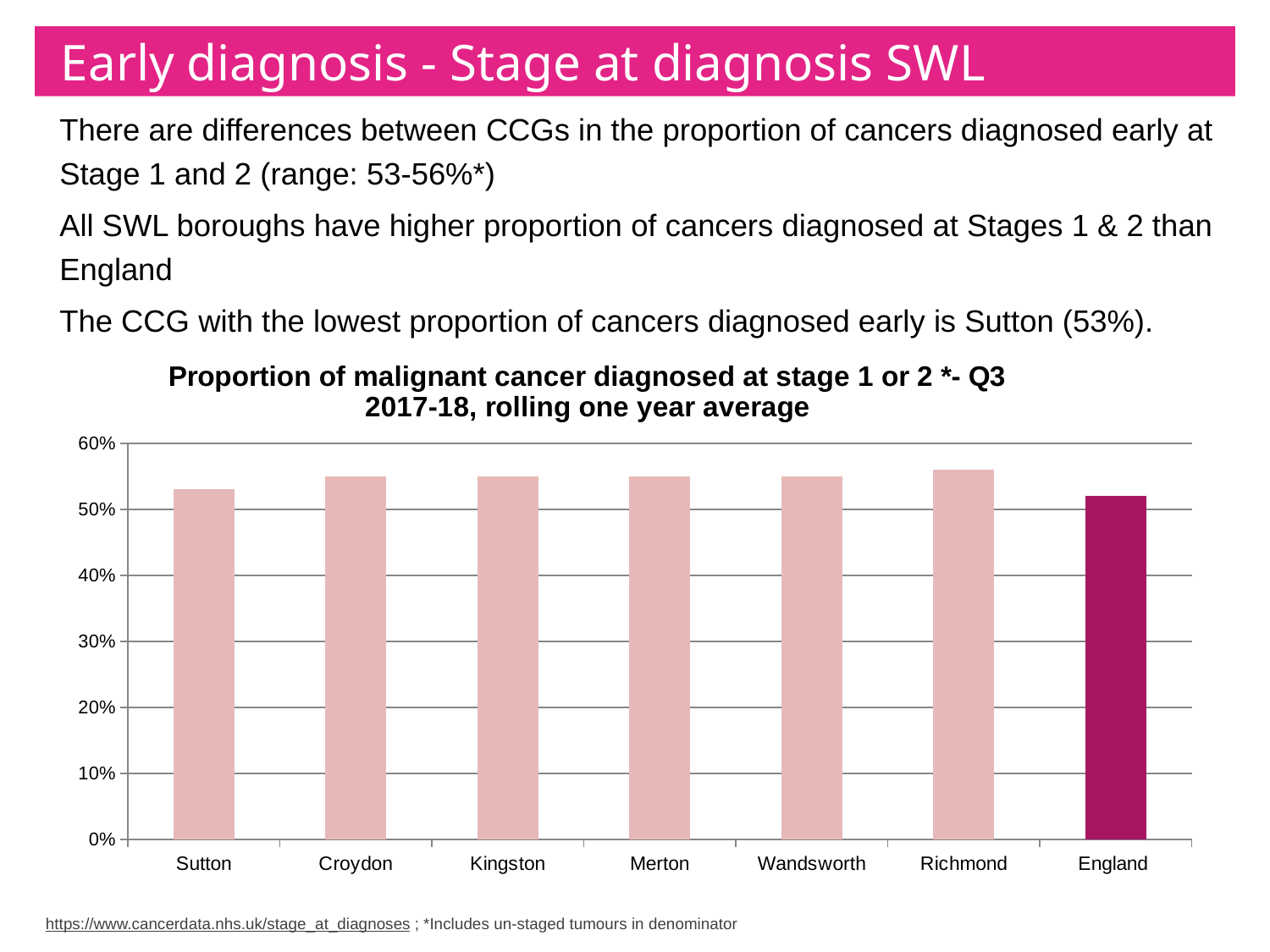
Which is larger, the value for Croydon or the value for Sutton? Croydon Which bar in the chart is shown in a darker colour than the others? England How many categories are plotted on the x axis of the chart? 7 Which is larger, the value for Richmond or the value for England? Richmond What kind of chart is shown on the slide? bar chart Is the value for Richmond greater or less than 60%? less Which category has the highest bar in the chart? Richmond What is the title of the chart? Proportion of malignant cancer diagnosed at stage 1 or 2 *- Q3 2017-18, rolling one year average Which category has the lowest bar in the chart? England Among the CCGs (excluding England), which has the lowest bar? Sutton Is the value for Sutton greater or less than 50%? greater Is the value for England greater or less than 50%? greater